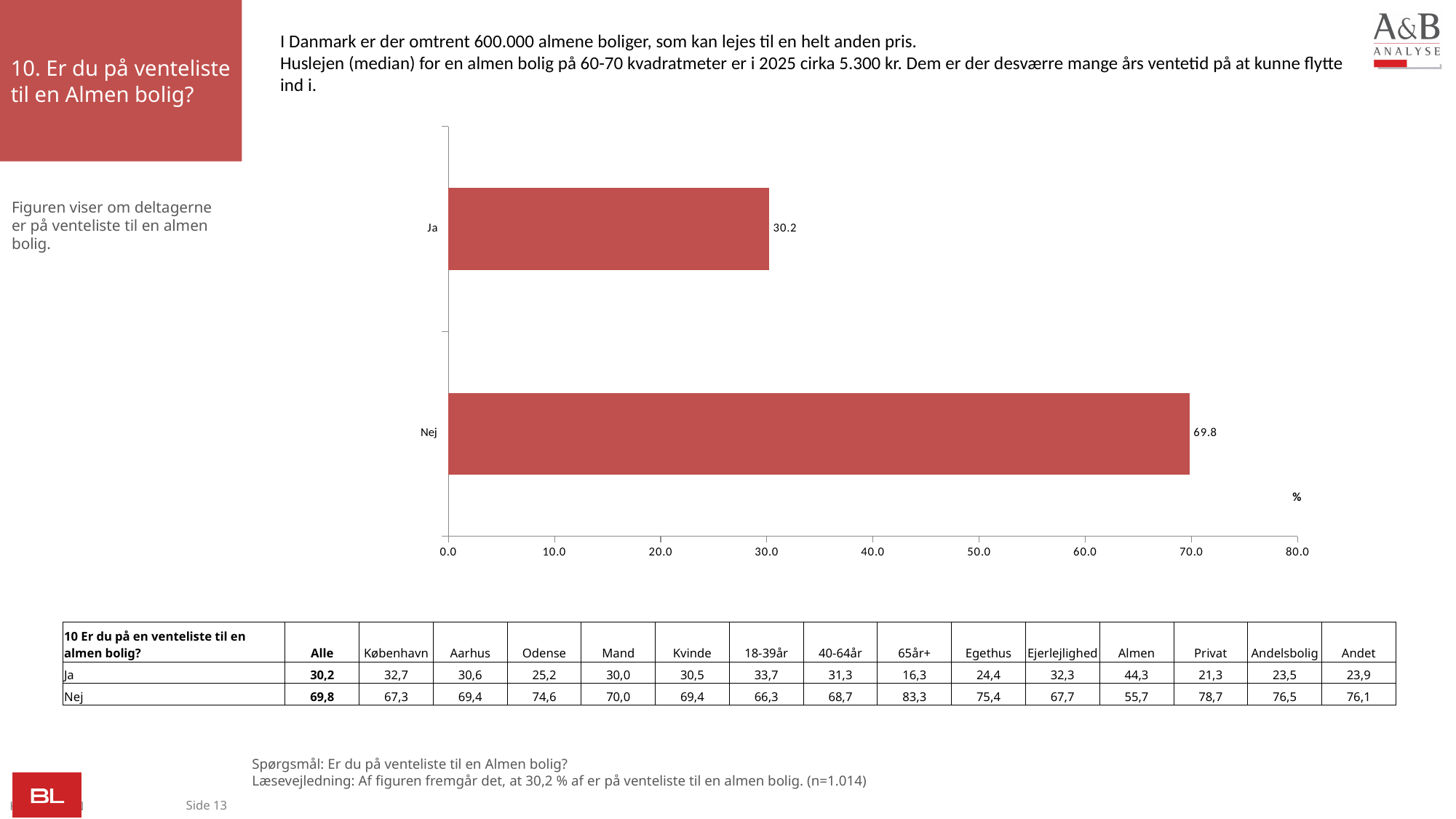
Which is larger in the bar chart, the value for "Ja" or the value for "Nej"? Nej What is the value for "Nej" in the bar chart? 69.8 Is the value for "Nej" in the bar chart greater or less than 60.0? greater What is the value for "Ja" in the bar chart? 30.2 Which category has the lowest value in the bar chart? Ja Which category has the highest value in the bar chart? Nej What is the total of the two bar values in the chart? 100.0 Is the value for "Ja" in the bar chart greater or less than 40.0? less How many categories are shown in the bar chart? 2 What is the maximum value shown on the horizontal axis of the bar chart? 80.0 What kind of chart is shown on the slide? Bar chart What is the difference between the values for "Nej" and "Ja" in the bar chart? 39.6